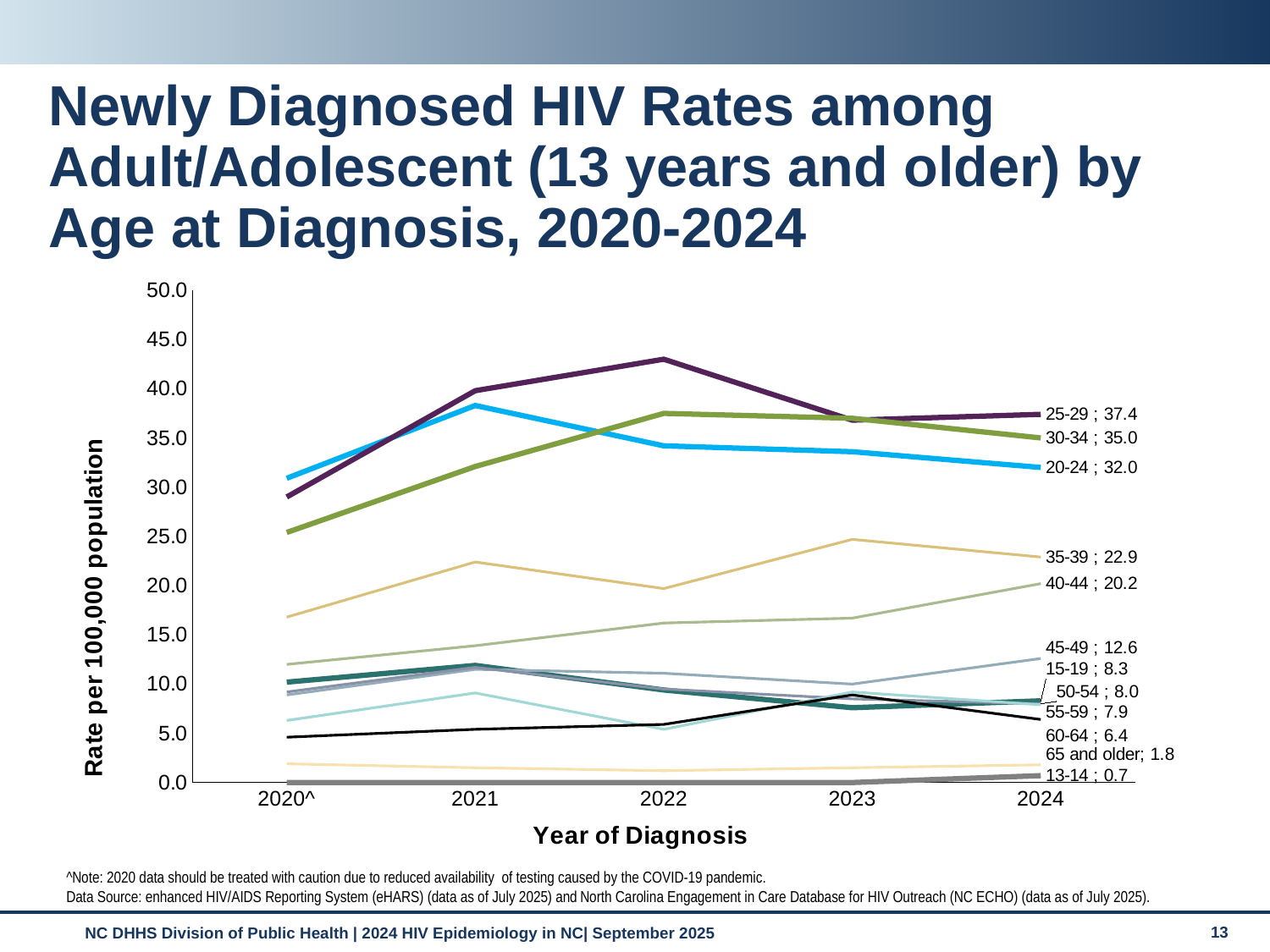
What is the 2024 rate for the 30-34 age group? 35.0 How many years of diagnosis are shown on the x axis? 5 Which age group has the lowest rate in 2024? 13-14 What is the difference between the 2024 rates for the 25-29 and 30-34 age groups? 2.4 What is the title of the y axis? Rate per 100,000 population In 2024, which age group has the higher rate, 35-39 or 40-44? 35-39 Is the 2020 rate for the 30-34 age group greater or less than 30.0? less What kind of chart is shown on the slide? line chart What is the 2024 rate for the 25-29 age group? 37.4 Is the 2022 rate for the 25-29 age group greater or less than 40.0? greater Which age group has the highest rate in 2024? 25-29 What is the difference between the 2024 rates for the 20-24 and 35-39 age groups? 9.1